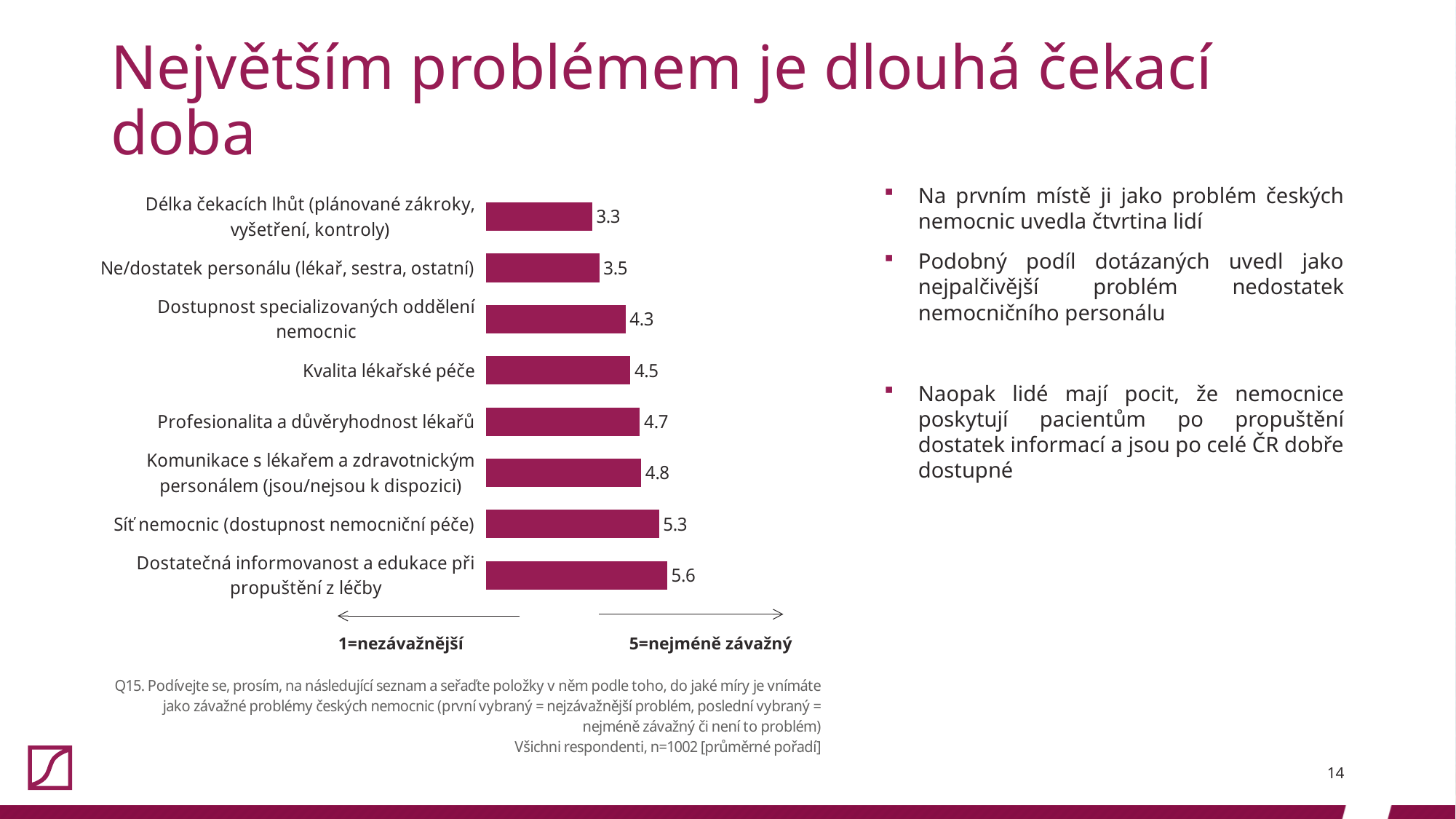
What is the difference between the values for "Dostatečná informovanost a edukace při propuštění z léčby" and "Délka čekacích lhůt (plánované zákroky, vyšetření, kontroly)"? 2.3 Which has a larger value: "Profesionalita a důvěryhodnost lékařů" or "Dostupnost specializovaných oddělení nemocnic"? Profesionalita a důvěryhodnost lékařů What kind of chart is shown on the slide? Bar chart What does the label at the left end of the axis arrow below the chart say? 1=nezávažnější What is the value for "Ne/dostatek personálu (lékař, sestra, ostatní)"? 3.5 Do the values increase or decrease going from the top bar to the bottom bar? Increase How many categories are shown in the chart? 8 Which category has the highest value? Dostatečná informovanost a edukace při propuštění z léčby What is the value for "Síť nemocnic (dostupnost nemocniční péče)"? 5.3 Which category has the lowest value? Délka čekacích lhůt (plánované zákroky, vyšetření, kontroly) What is the value for "Kvalita lékařské péče"? 4.5 What is the value for "Délka čekacích lhůt (plánované zákroky, vyšetření, kontroly)"? 3.3